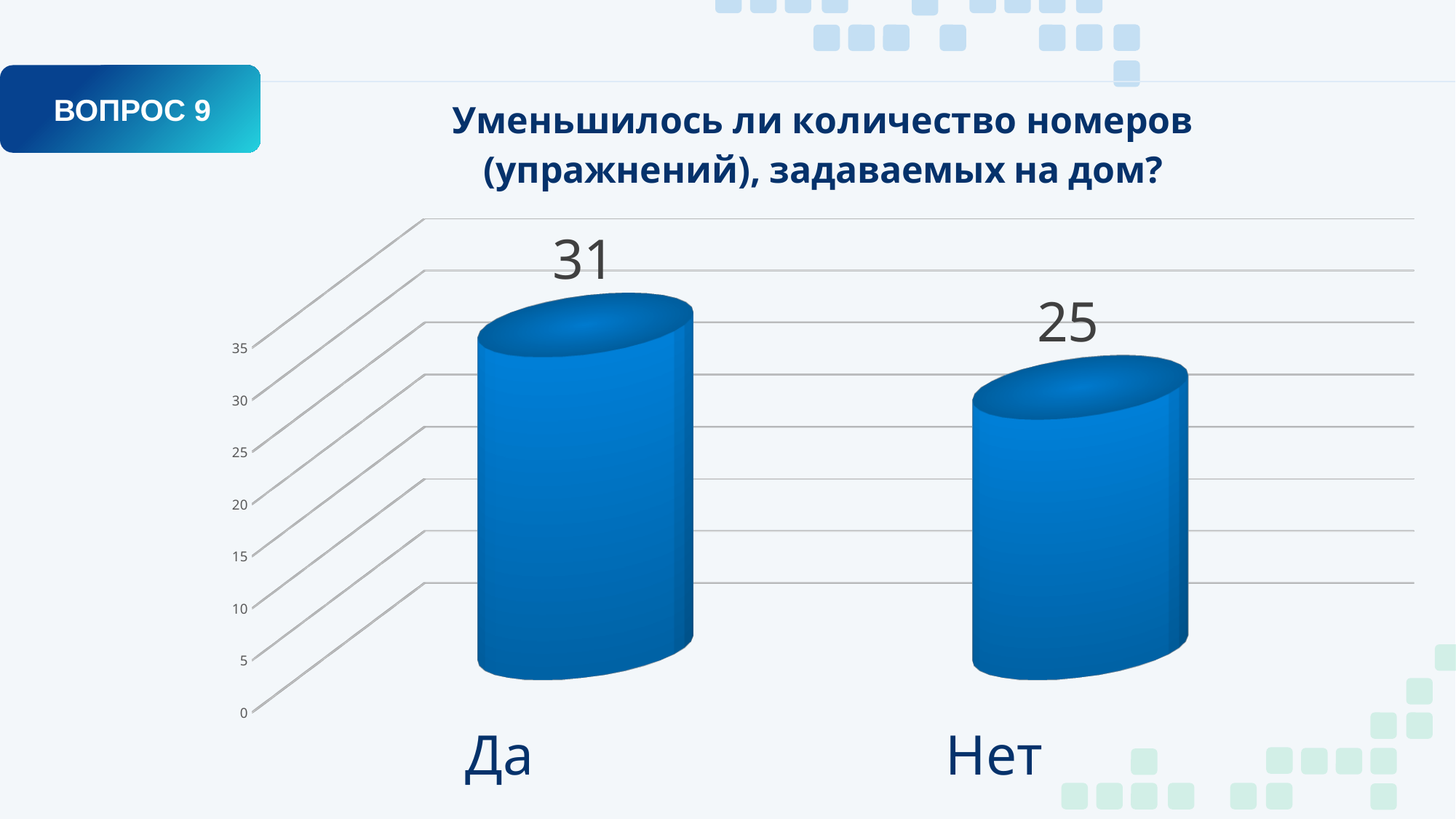
Is the value for "Да" greater or less than 30? greater Is the value for "Нет" greater or less than 30? less What is the total of the values for "Да" and "Нет"? 56 Which category has the lowest value? Нет What is the value for "Нет"? 25 Which is larger, the value for "Да" or the value for "Нет"? Да What is the difference between the values for "Да" and "Нет"? 6 How many categories are shown in the chart? 2 What is the title of the chart? Уменьшилось ли количество номеров (упражнений), задаваемых на дом? Which category has the highest value? Да What kind of chart is shown on the slide? bar chart What is the value for "Да"? 31